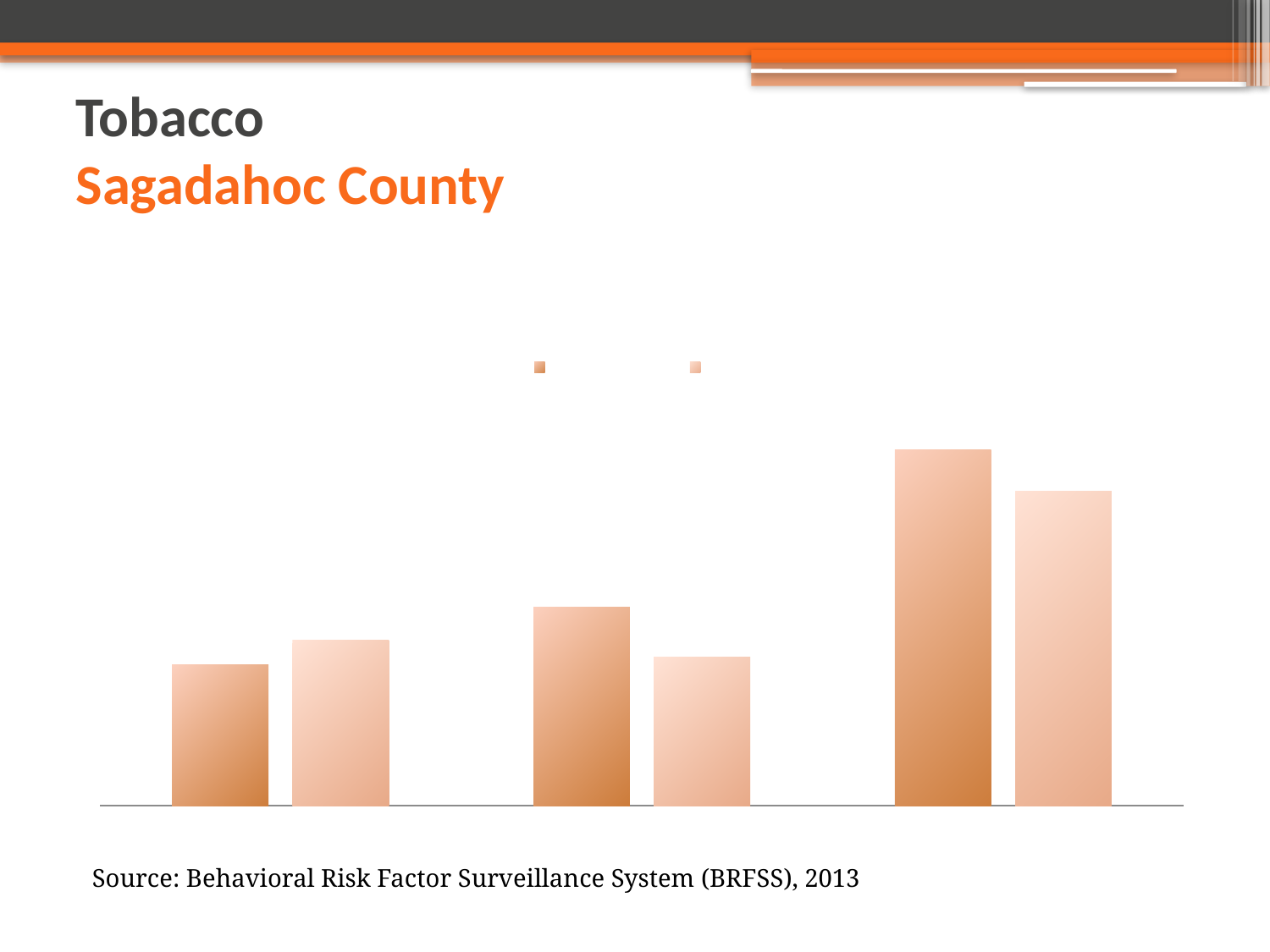
How many bars are plotted in total on the chart? 6 Do the darker (left) bars rise or fall from the first group to the third group? Rise In the third group of bars, which is taller: the darker left bar or the lighter right bar? The darker left bar Which group of bars, counting from the left, contains the tallest bar? The third group Which group of bars, counting from the left, contains the shortest bar? The first group What data source is cited below the chart? Behavioral Risk Factor Surveillance System (BRFSS), 2013 Which county is named in the slide title above the chart? Sagadahoc County In the first group of bars, which is taller: the darker left bar or the lighter right bar? The lighter right bar How many groups of bars are plotted along the x axis? 3 What kind of chart is shown on the slide? Bar chart How many series does the chart's legend list? 2